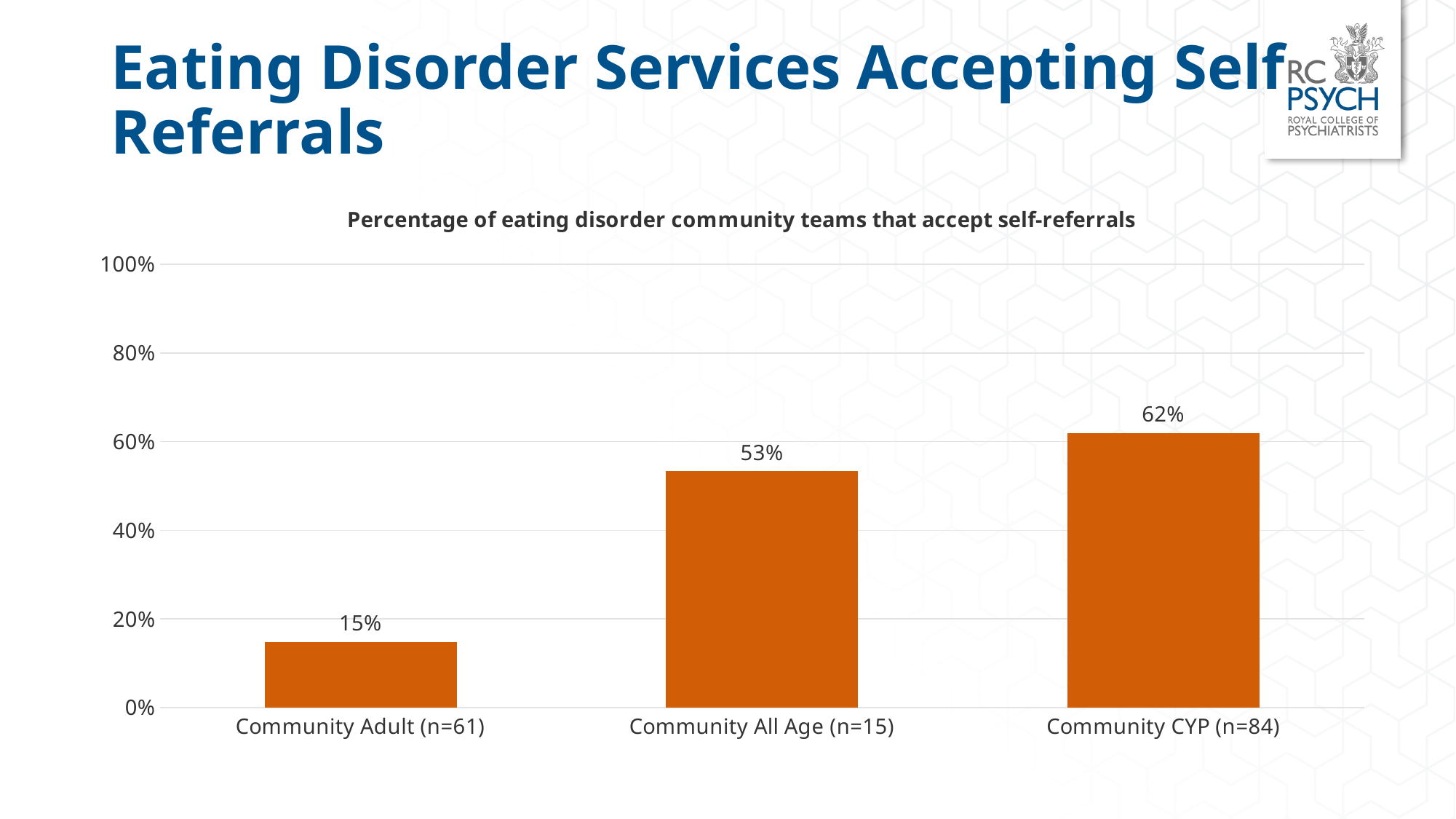
What is the difference in percentage points between Community CYP (n=84) and Community Adult (n=61)? 47 Is the value for Community All Age (n=15) greater or less than 40%? greater Which category has the lowest percentage of teams accepting self-referrals? Community Adult (n=61) What is the difference in percentage points between Community CYP (n=84) and Community All Age (n=15)? 9 What is the value shown for Community All Age (n=15)? 53% What percentage of Community Adult (n=61) teams accept self-referrals? 15% What kind of chart is shown on the slide? Bar chart Which category has the highest percentage of teams accepting self-referrals? Community CYP (n=84) Which is larger, the value for Community All Age (n=15) or Community Adult (n=61)? Community All Age (n=15) What is the value shown for Community CYP (n=84)? 62% How many categories are shown on the x axis? 3 What is the title of the chart? Percentage of eating disorder community teams that accept self-referrals